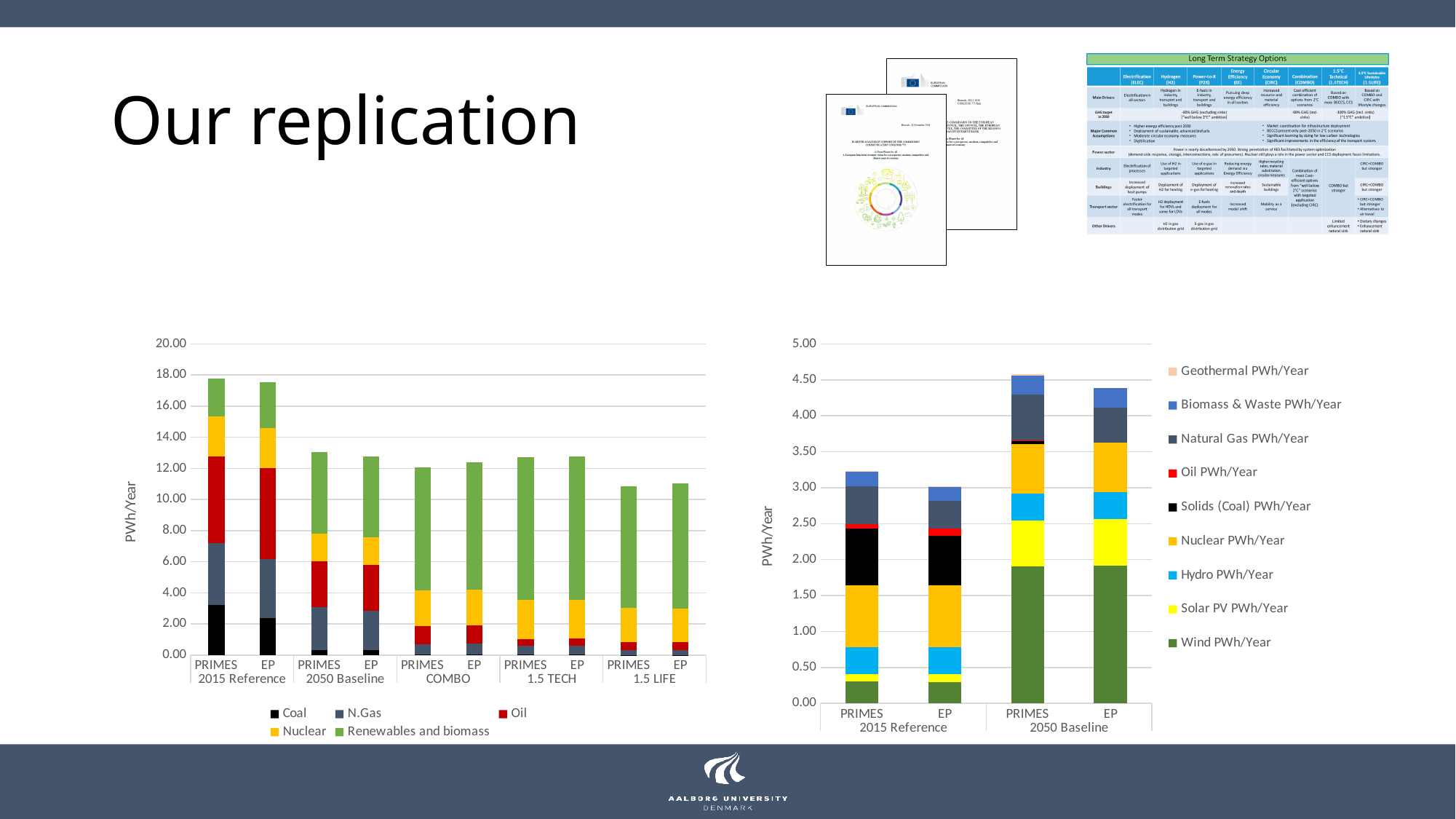
In the left chart, is the total for the EP 1.5 LIFE bar greater or less than 12.00? less How many series does the legend of the right chart list? 9 What is the y-axis label of the right chart? PWh/Year What kind of chart is the left chart on the slide? Stacked bar chart In the right chart, which bar has the lowest total? EP 2015 Reference How many bars are plotted in the left chart? 10 In the left chart, which bar has the larger total: PRIMES 2050 Baseline or PRIMES COMBO? PRIMES 2050 Baseline How many bars are plotted in the right chart? 4 How many series does the legend of the left chart list? 5 In the left chart, is the total for the PRIMES 2015 Reference bar greater or less than 16.00? greater In the right chart, is the total for the PRIMES 2050 Baseline bar greater or less than 4.00? greater